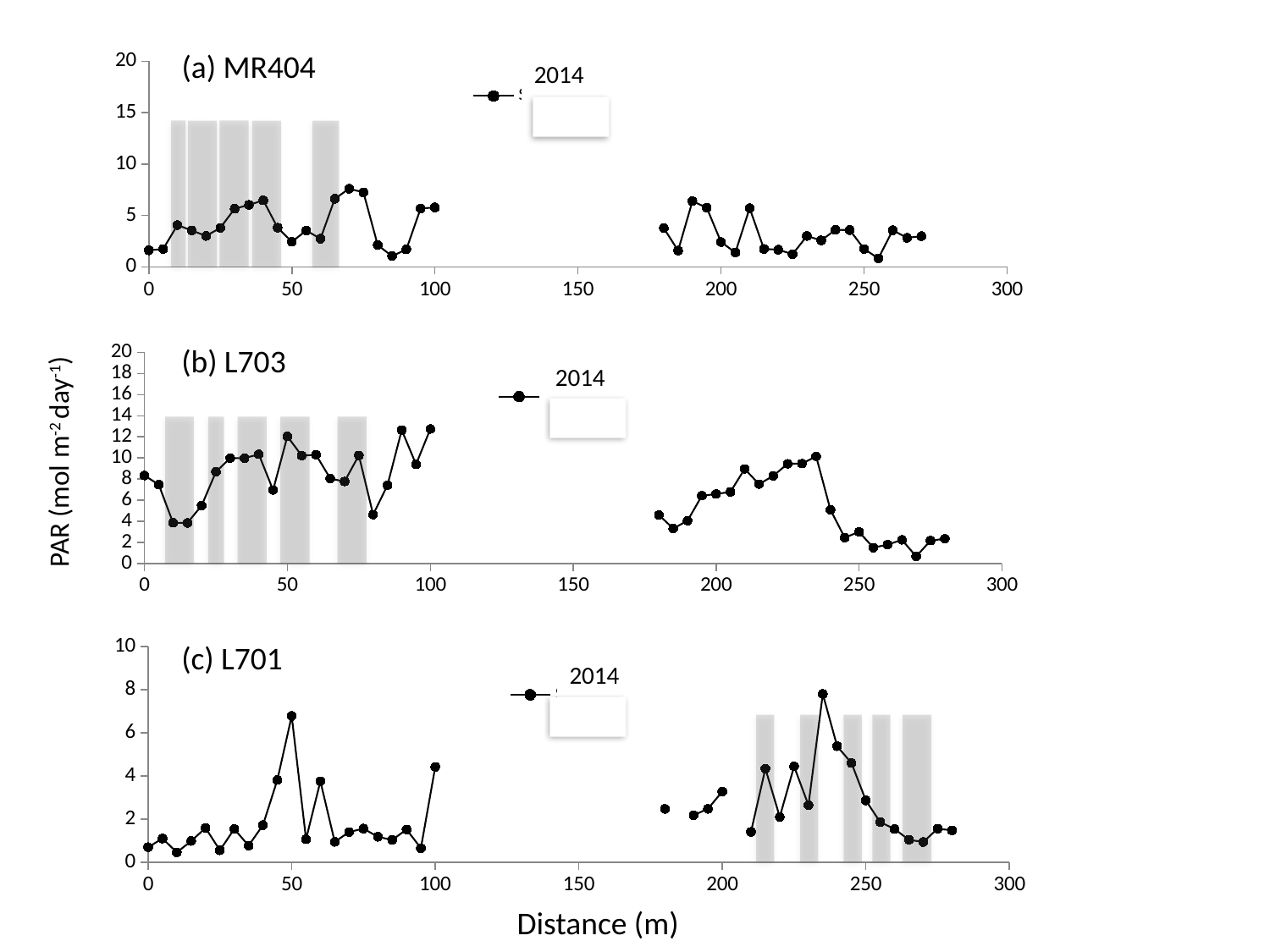
What kind of chart is chart (a) MR404? line chart In chart (b) L703, which is larger: the value at 0 m or the value at 280 m? the value at 0 m In chart (b) L703, is the value at a distance of 0 m greater or less than 6? greater In chart (b) L703, do the values generally rise or fall between 180 m and 235 m? rise In chart (a) MR404, is the value at a distance of 0 m greater or less than 5? less What year is shown in the legend of chart (c) L701? 2014 In chart (b) L703, is the value at a distance of 100 m greater or less than 10? greater In chart (c) L701, which is larger: the value at 50 m or the value at 0 m? the value at 50 m What is the label of the shared x axis at the bottom of the slide? Distance (m)